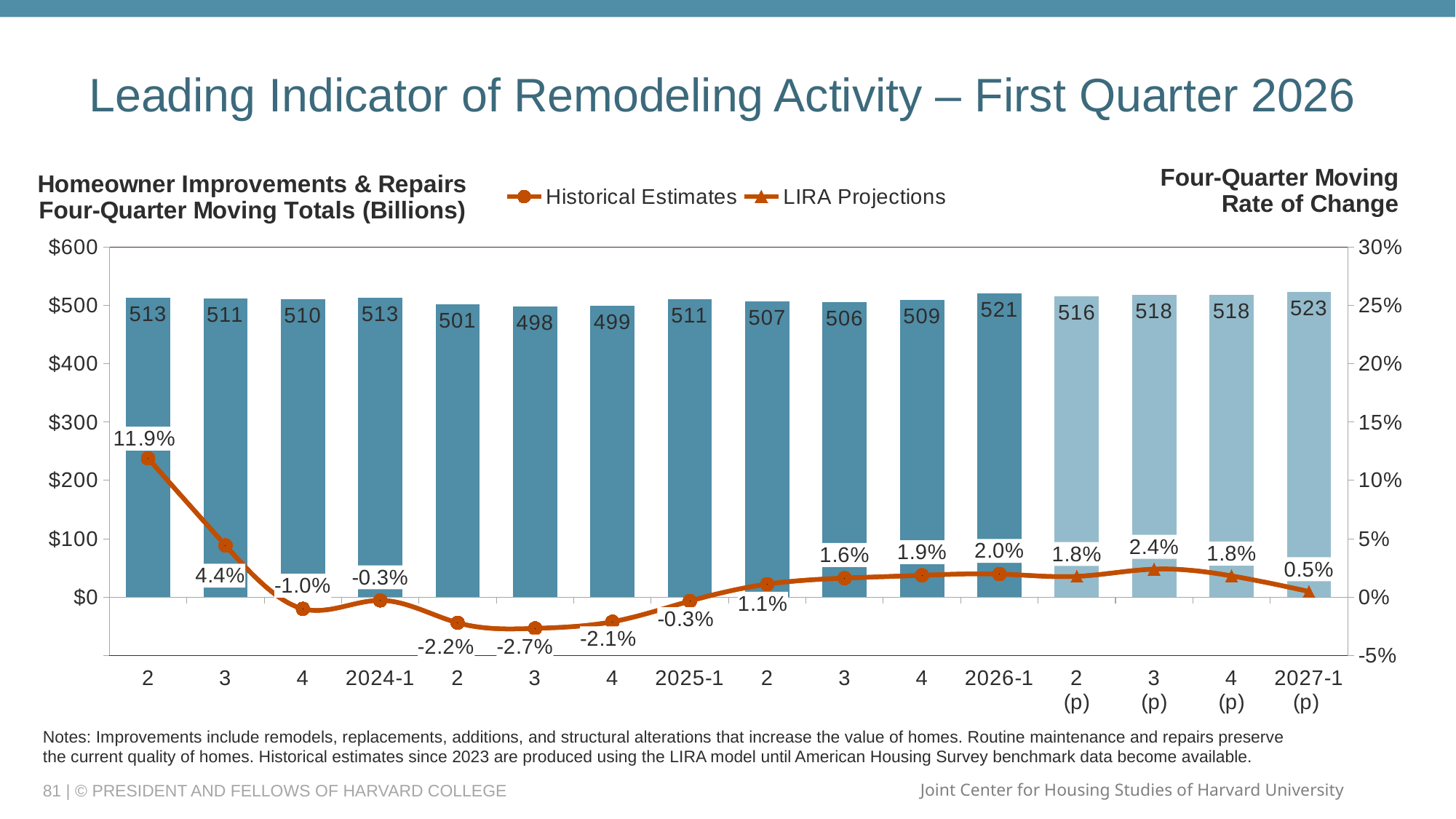
Which has the larger four-quarter moving total, 2024-1 or 2025-1? 2024-1 What is the highest four-quarter moving rate of change shown on the chart? 11.9% What is the four-quarter moving total (in billions) for 2026-1? 521 What is the lowest four-quarter moving rate of change shown on the chart? -2.7% What is the lowest four-quarter moving total shown on the chart? 498 What kind of chart is shown on the slide? Combined bar and line chart What is the four-quarter moving rate of change for the projected quarter 3 (p)? 2.4% How many quarters are plotted along the x axis? 16 How many series does the legend list? 2 How much higher is the four-quarter moving total for 2027-1 (p) than for 2026-1? 2 What is the four-quarter moving rate of change for 2025-1? -0.3% Which quarter has the highest four-quarter moving total? 2027-1 (p)